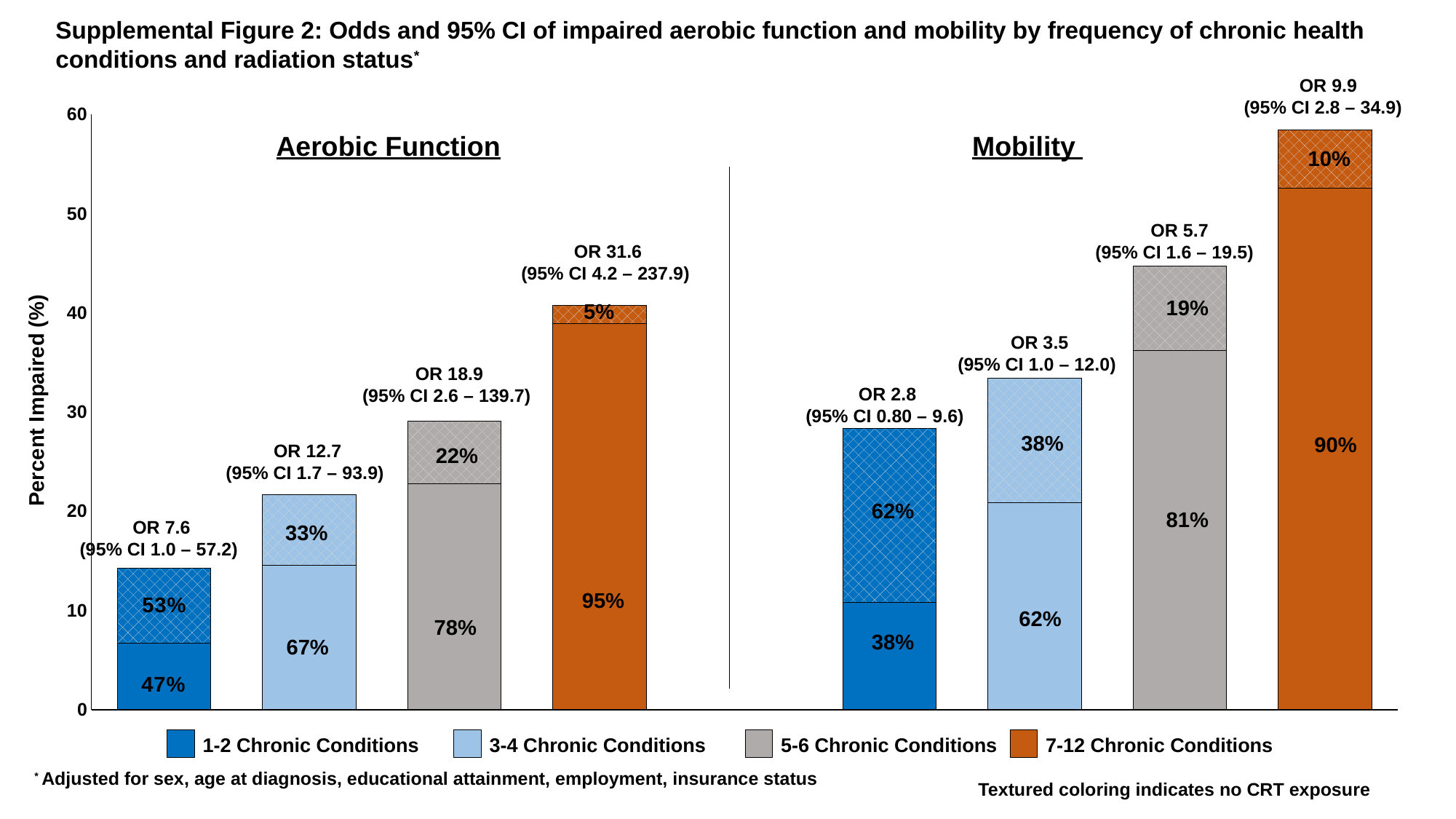
In the Mobility panel, does percent impaired rise or fall as the number of chronic conditions increases? rise What kind of chart is shown on the slide? stacked bar chart In the Mobility panel, what 95% CI is printed above the 5-6 Chronic Conditions bar? 1.6 – 19.5 In the Mobility panel, what odds ratio is printed above the 1-2 Chronic Conditions bar? OR 2.8 In the Mobility panel, what percentage label is shown in the solid segment of the 7-12 Chronic Conditions bar? 90% In the Mobility panel, is the total height of the 7-12 Chronic Conditions bar greater or less than 50? greater Across both panels, which bar reaches the highest percent impaired? 7-12 Chronic Conditions in Mobility In the Aerobic Function panel, what odds ratio is printed above the 7-12 Chronic Conditions bar? OR 31.6 In the Aerobic Function panel, what percentage label is shown in the textured (no CRT exposure) segment of the 7-12 Chronic Conditions bar? 5% In the Aerobic Function panel, is the total height of the 1-2 Chronic Conditions bar greater or less than 20? less How many series does the legend list? 4 How many bars are shown in the Aerobic Function panel? 4